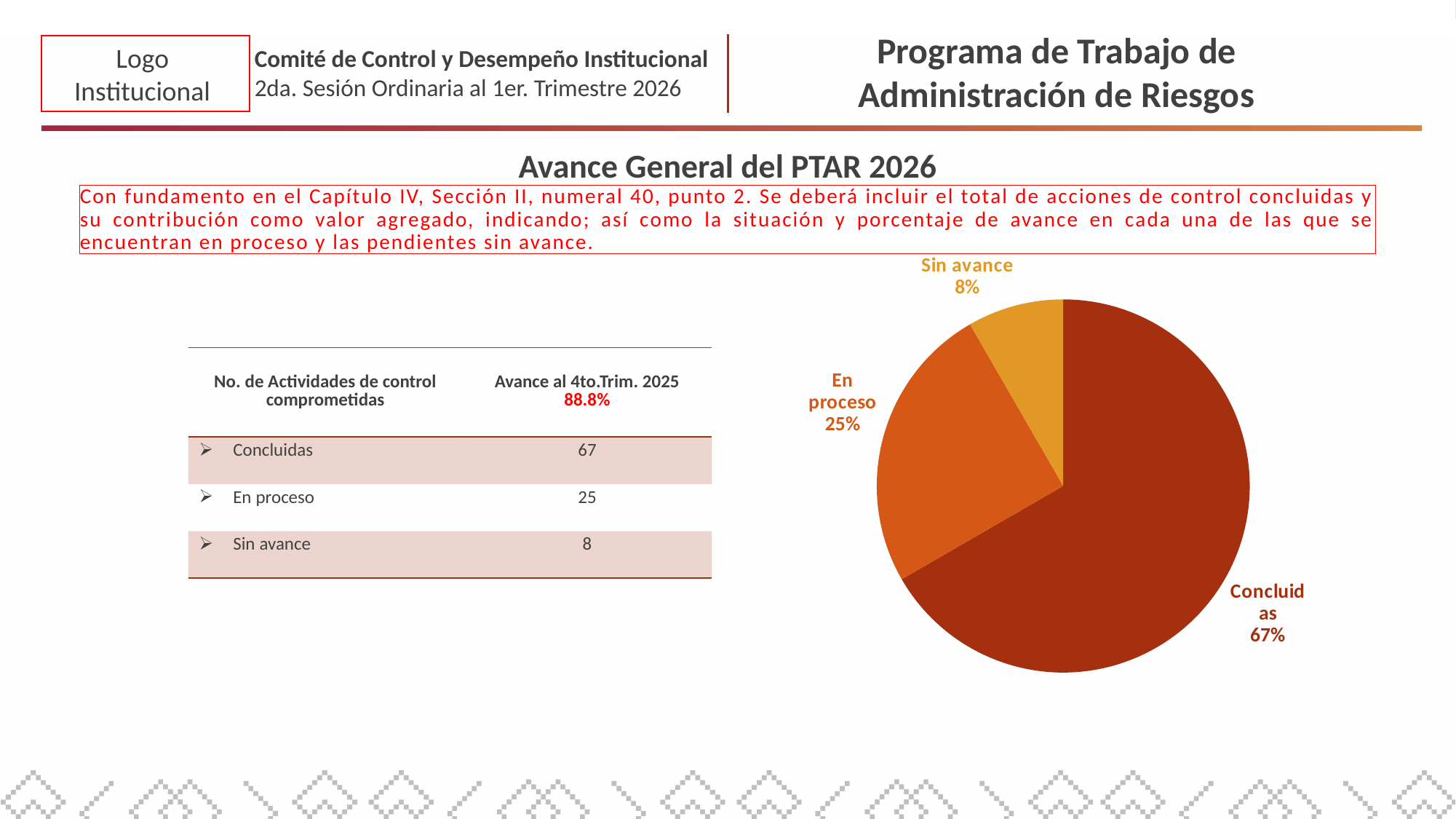
Which slice of the pie chart is the smallest? Sin avance Which slice of the pie chart is the largest? Concluidas What is the difference in percentage points between the Concluidas slice and the En proceso slice? 42% What is the title shown above the chart and table on the slide? Avance General del PTAR 2026 What colour is the Sin avance slice of the pie chart? yellow-orange What share of the pie does En proceso represent? 25% What kind of chart is shown on the slide? pie chart What is the difference in percentage points between the En proceso slice and the Sin avance slice? 17% Which is larger in the pie chart, En proceso or Sin avance? En proceso What share of the pie does Concluidas represent? 67% What share of the pie does Sin avance represent? 8% How many slices does the pie chart have? 3